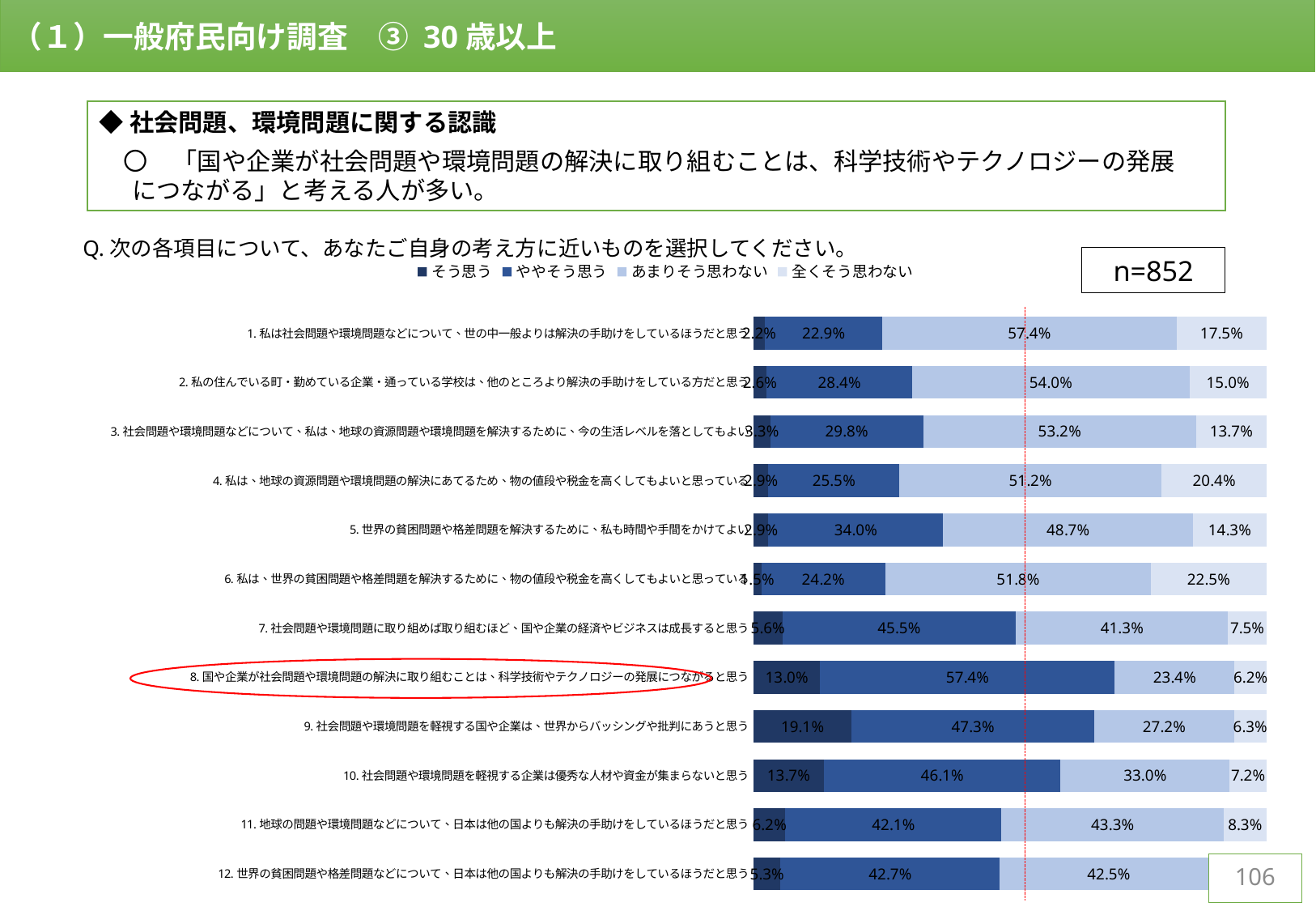
What type of chart is shown on the slide? Stacked bar chart Which item has the highest percentage for 全くそう思わない? Item 6 (22.5%) What percentage of respondents answered 全くそう思わない for item 6? 22.5% How many response categories does the legend list? 4 What percentage of respondents answered そう思う for item 9 (社会問題や環境問題を軽視する国や企業は、世界からバッシングや批判にあうと思う)? 19.1% What percentage of respondents answered ややそう思う for item 8 (国や企業が社会問題や環境問題の解決に取り組むことは、科学技術やテクノロジーの発展につながると思う)? 57.4% Which item has the highest percentage for そう思う? Item 9 (19.1%) What percentage of respondents answered あまりそう思わない for item 1? 57.4% What is the difference in the ややそう思う percentage between item 8 and item 9? 10.1 percentage points How many items (categories) are shown in the chart? 12 Which item has the highest percentage for ややそう思う? Item 8 (57.4%) Which has a larger ややそう思う percentage, item 4 or item 5? Item 5 (34.0%)